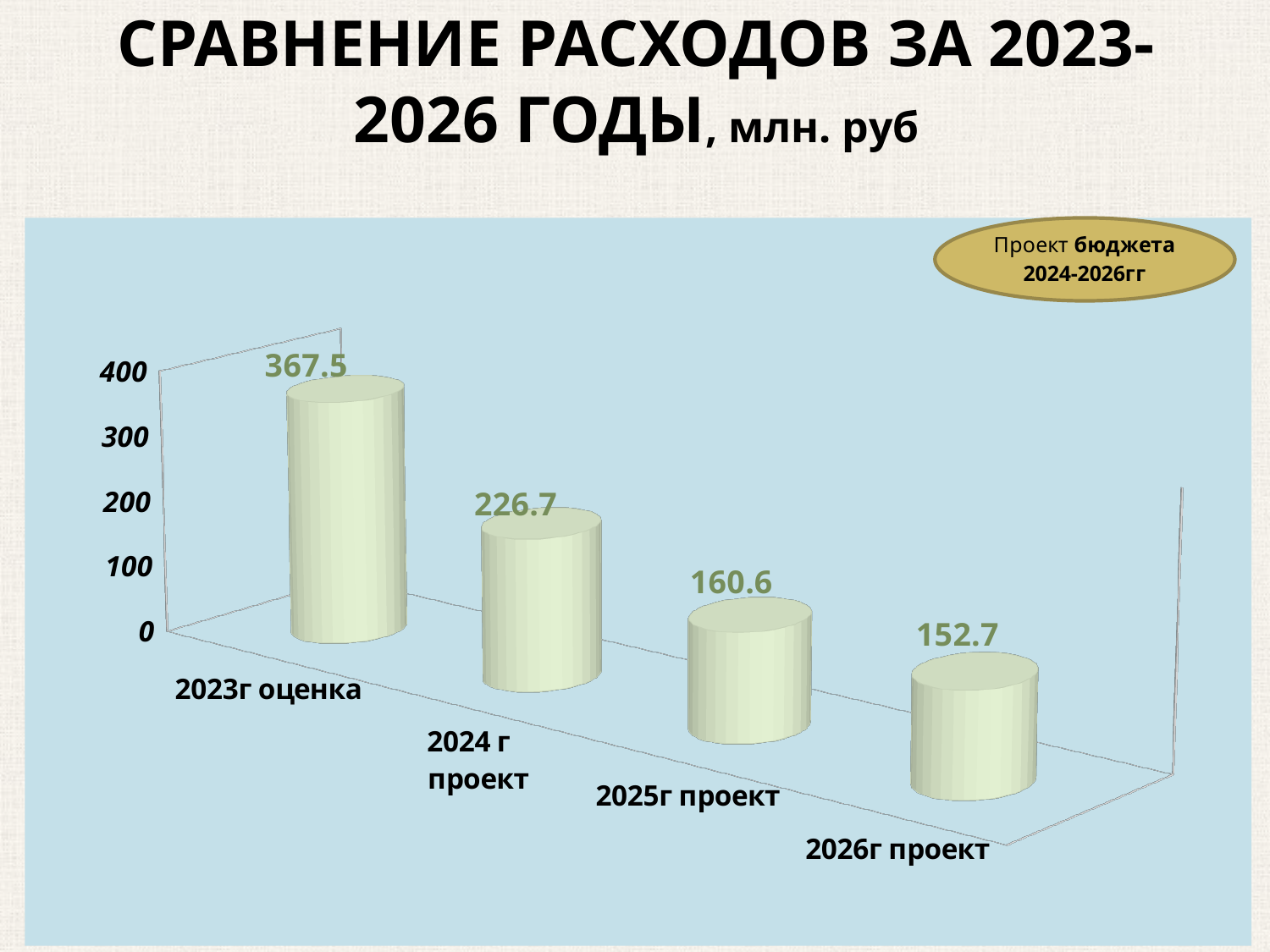
Do the values rise or fall from 2023г оценка to 2026г проект? fall What is the value for 2024 г проект? 226.7 How many categories are shown in the chart? 4 What is the difference between the values for 2025г проект and 2026г проект? 7.9 Which category has the highest value? 2023г оценка What is the value for 2025г проект? 160.6 What is the value for 2026г проект? 152.7 What is the difference between the values for 2023г оценка and 2024 г проект? 140.8 What is the value for 2023г оценка? 367.5 Which is larger, the value for 2024 г проект or the value for 2025г проект? 2024 г проект What kind of chart is shown on the slide? bar chart Which category has the lowest value? 2026г проект